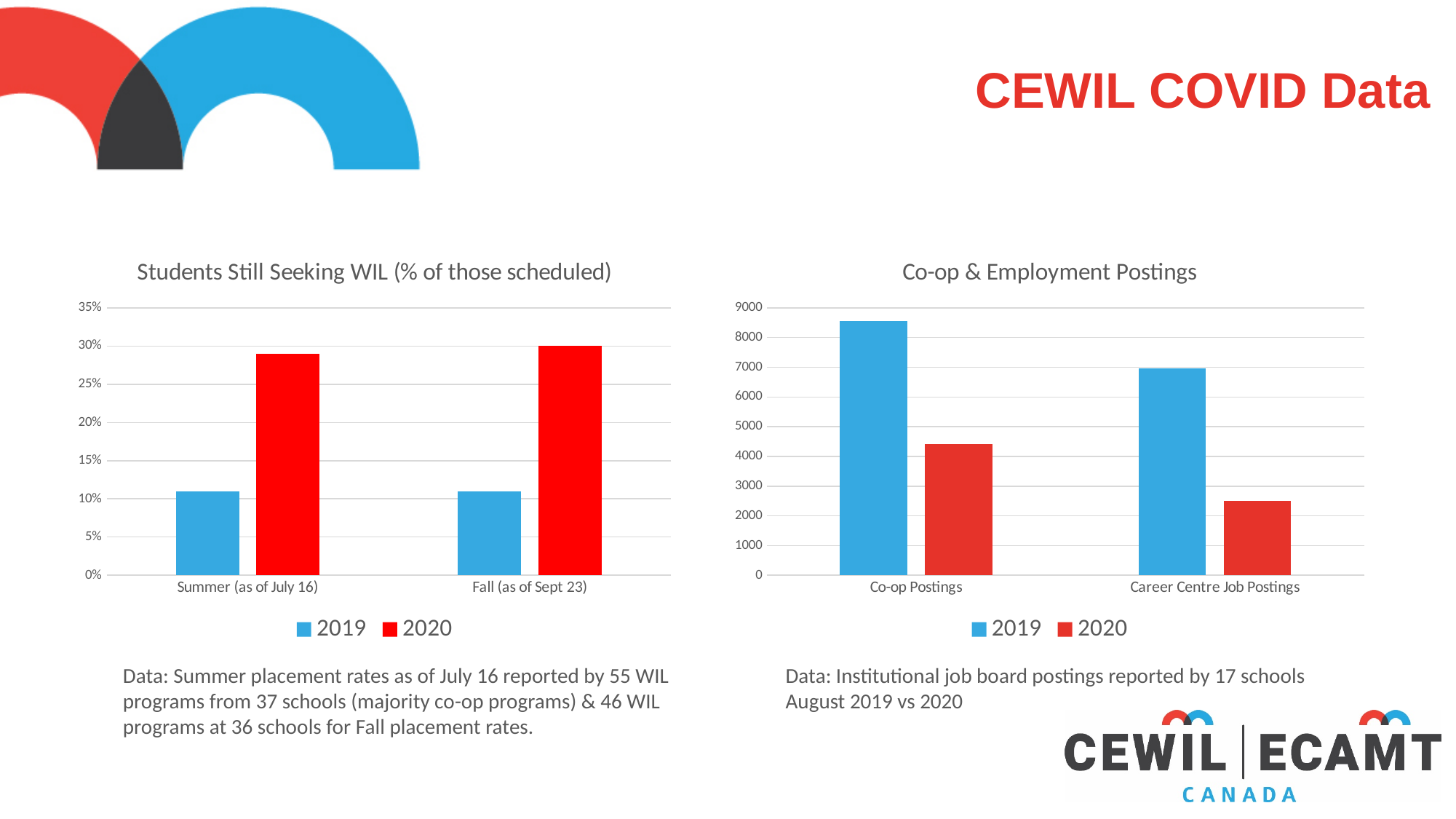
In the 'Students Still Seeking WIL (% of those scheduled)' chart, is the 2020 value for Summer (as of July 16) greater or less than 25%? greater In the 'Co-op & Employment Postings' chart, which bar is the tallest? 2019 Co-op Postings In the 'Co-op & Employment Postings' chart, which bar is the shortest? 2020 Career Centre Job Postings In the 'Co-op & Employment Postings' chart, is the 2019 value for Co-op Postings greater or less than 8000? greater What colour represents the 2020 series in the 'Co-op & Employment Postings' chart? red What kind of chart is the 'Students Still Seeking WIL (% of those scheduled)' chart? bar chart In the 'Students Still Seeking WIL (% of those scheduled)' chart, is the 2019 value for Fall (as of Sept 23) greater or less than 15%? less How many categories are shown on the x axis of the 'Students Still Seeking WIL (% of those scheduled)' chart? 2 How many series does the legend of the 'Co-op & Employment Postings' chart list? 2 In the 'Students Still Seeking WIL (% of those scheduled)' chart, which series has the larger value for Summer (as of July 16), 2019 or 2020? 2020 In the 'Co-op & Employment Postings' chart, which is larger for Career Centre Job Postings, the 2019 value or the 2020 value? 2019